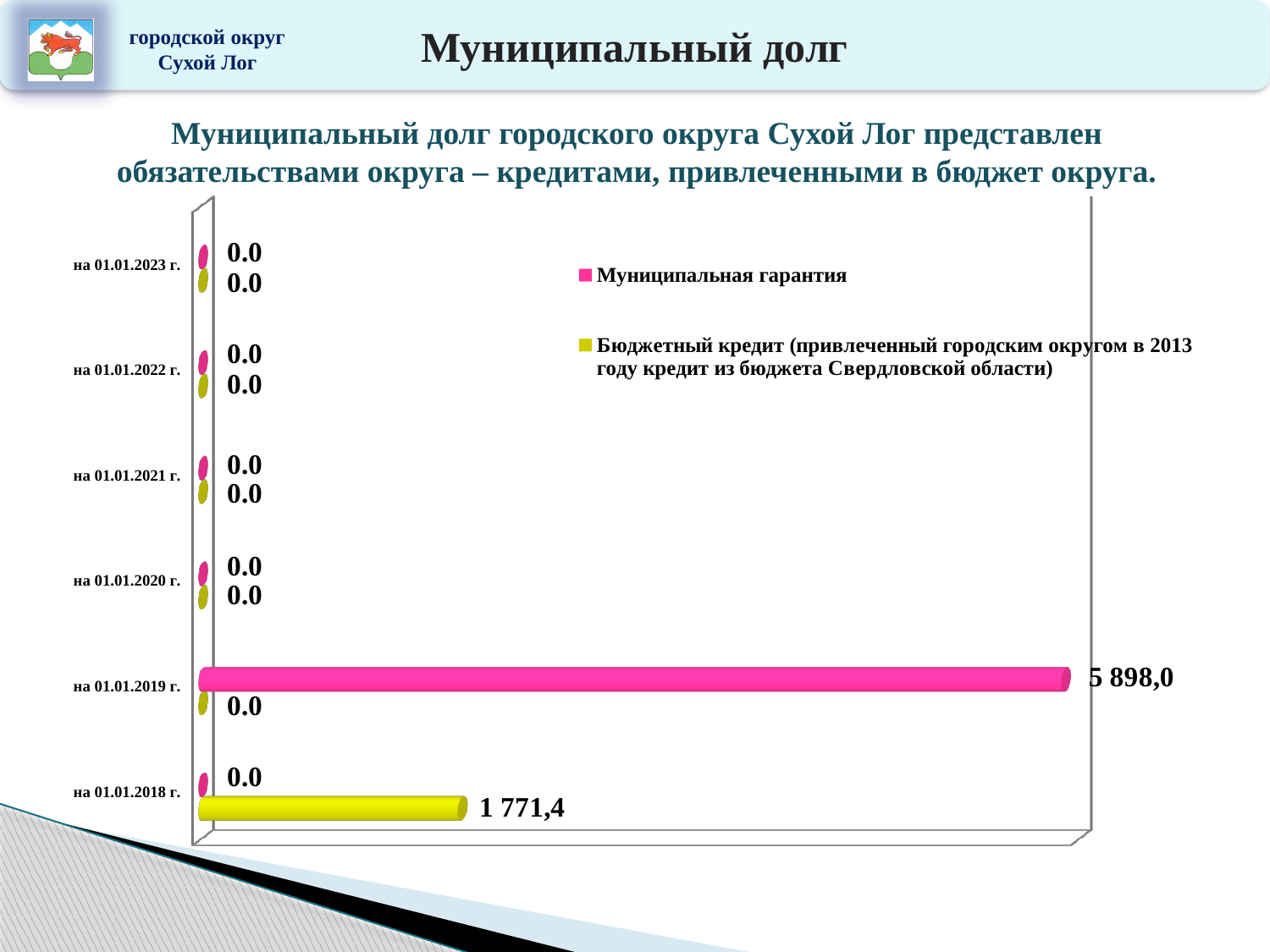
What kind of chart is shown on the slide? bar chart How many date categories are shown on the chart? 6 Which is larger: Муниципальная гарантия на 01.01.2019 г. or Бюджетный кредит на 01.01.2018 г.? Муниципальная гарантия на 01.01.2019 г. How many series does the legend list? 2 What is the value of Муниципальная гарантия на 01.01.2018 г.? 0.0 What is the value of Муниципальная гарантия на 01.01.2019 г.? 5 898,0 Which date has the highest value for Бюджетный кредит? на 01.01.2018 г. What is the value of Бюджетный кредит на 01.01.2018 г.? 1 771,4 What colour represents the series Муниципальная гарантия in the legend? pink What is the value of Бюджетный кредит на 01.01.2019 г.? 0.0 What is the value of Бюджетный кредит на 01.01.2023 г.? 0.0 Which date has the highest value for Муниципальная гарантия? на 01.01.2019 г.